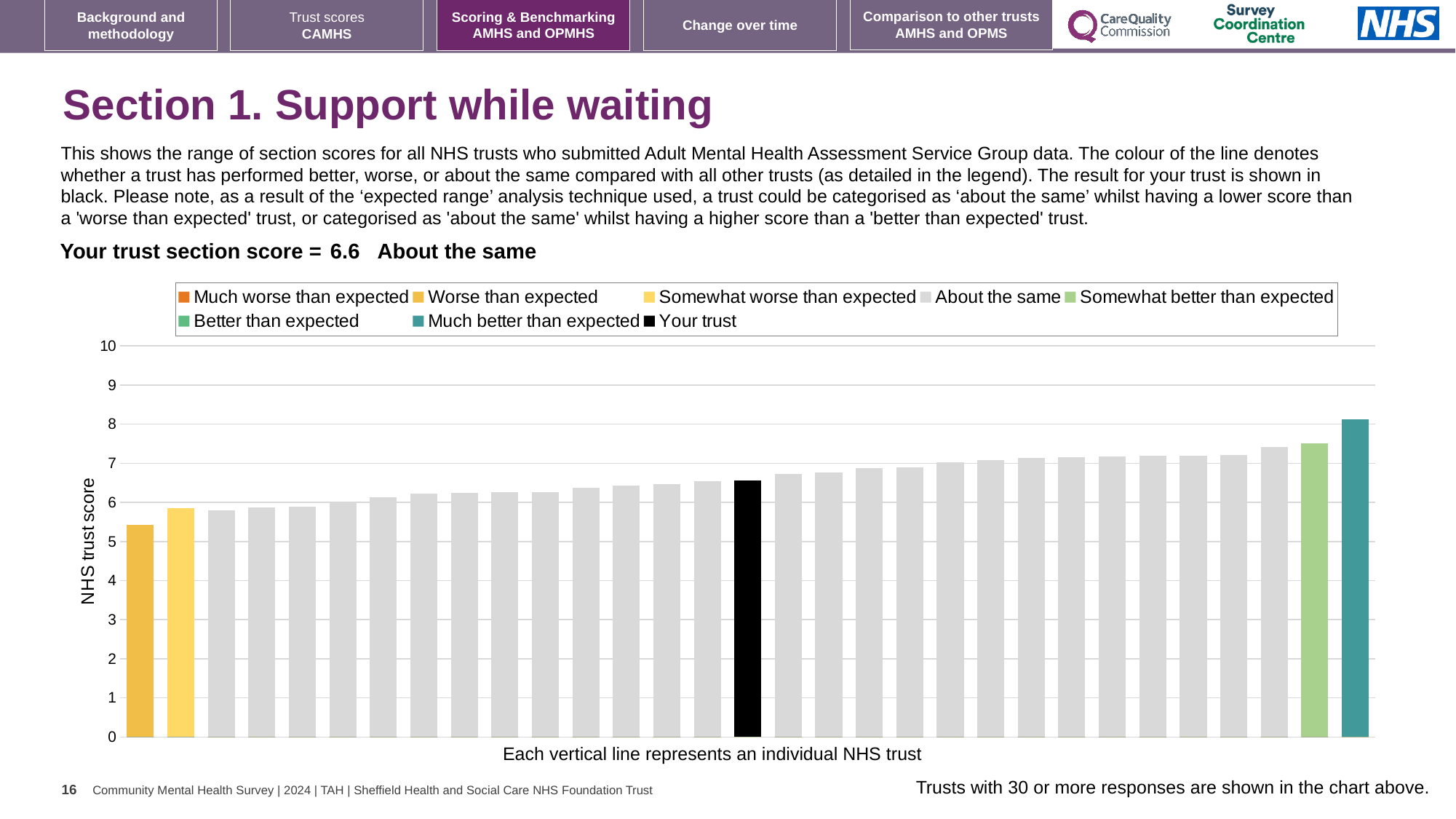
Which bar has the lowest value in the chart? the leftmost bar (Worse than expected) Is the value of the rightmost bar greater or less than 7? greater What colour is the bar representing your trust? black Do the bar values rise or fall from left to right across the chart? rise Which is larger: the value for your trust or the value of the leftmost bar? your trust Which category does your trust fall into according to the slide? About the same Is the value of the leftmost bar greater or less than 6? less Is the value of the black bar (your trust) greater or less than 6? greater What is the section score for your trust shown on the slide? 6.6 Which bar has the highest value in the chart? the rightmost bar (Much better than expected) What kind of chart is shown on the slide? bar chart How many entries does the chart legend list? 8